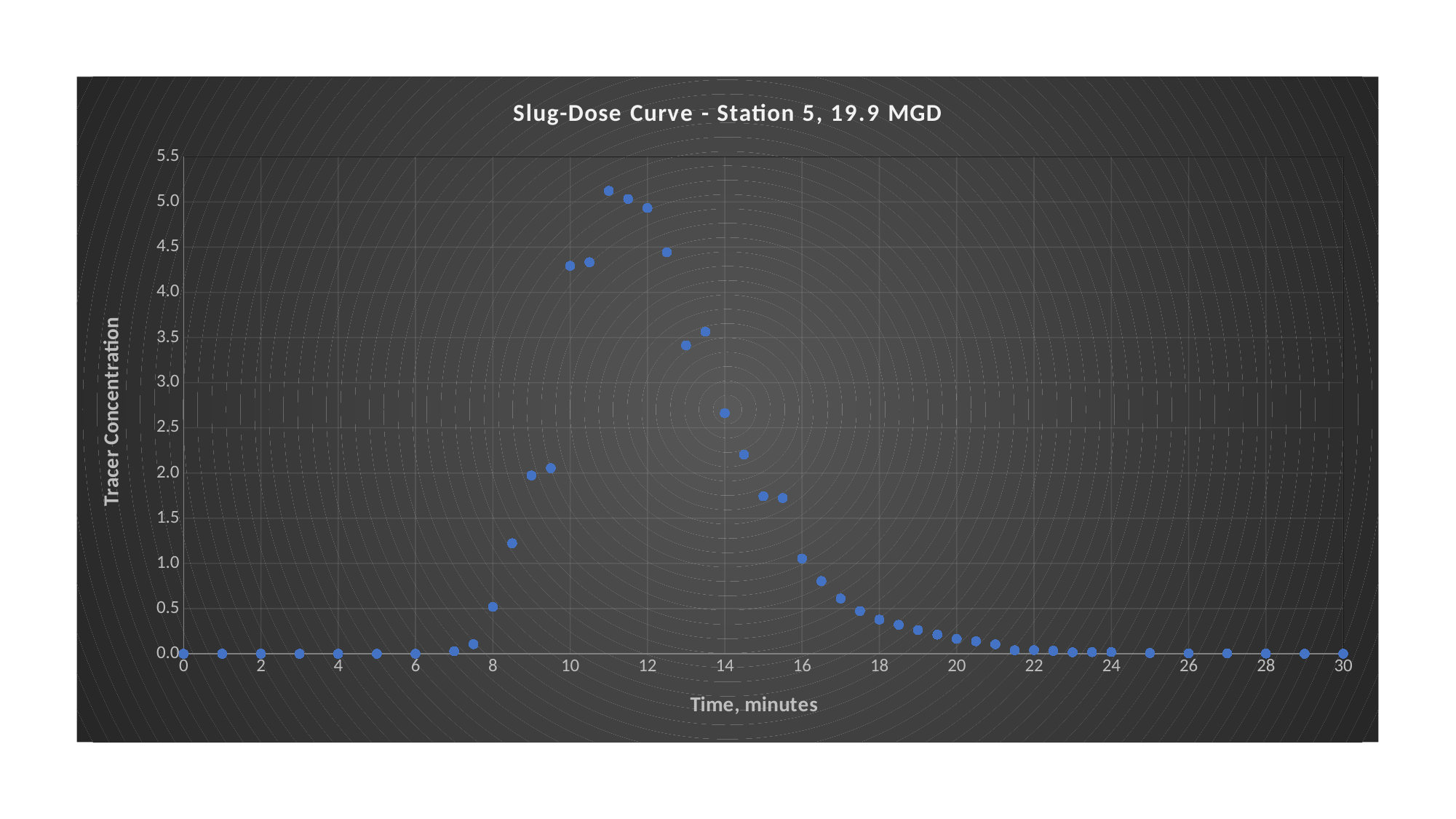
Do the tracer concentration values rise or fall between 12 minutes and 22 minutes? fall Do the tracer concentration values rise or fall between 7 minutes and 11 minutes? rise Is the tracer concentration at 13 minutes greater or less than 3.5? less What is the label of the x axis? Time, minutes Is the tracer concentration at 18 minutes greater or less than 0.5? less What is the title of the chart? Slug-Dose Curve - Station 5, 19.9 MGD What kind of chart is shown on the slide? scatter chart Is the tracer concentration at 14 minutes greater or less than 2.5? greater Which has the higher tracer concentration, 10 minutes or 16 minutes? 10 minutes What is the tracer concentration at time 0 minutes? 0.0